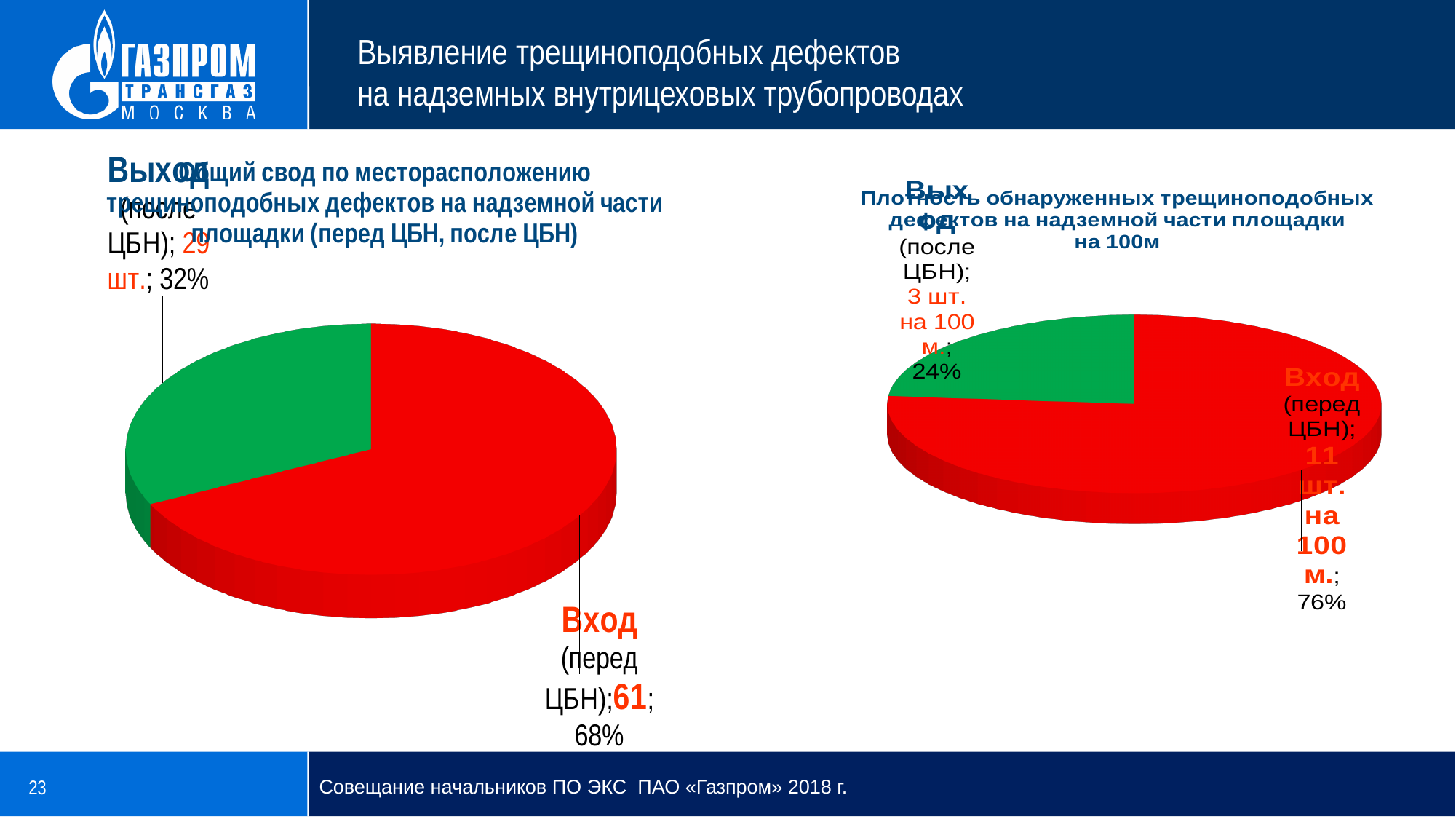
In the left pie chart, how many defects are shown for Выход (после ЦБН)? 29 шт. In the left pie chart, what share of the pie does Выход (после ЦБН) take? 32% In the right pie chart, which category has the smallest slice? Выход (после ЦБН) In the right pie chart, what is the defect density for Выход (после ЦБН)? 3 шт. на 100 м. How many slices does the left pie chart have? 2 What type of chart is the left chart on the slide? Pie chart In the left pie chart, what share of the pie does Вход (перед ЦБН) take? 68% In the right pie chart, what share of the pie does Вход (перед ЦБН) take? 76% In the right pie chart, what is the defect density for Вход (перед ЦБН)? 11 шт. на 100 м. In the left pie chart, which category has the largest slice? Вход (перед ЦБН) In the left pie chart, how many defects are shown for Вход (перед ЦБН)? 61 In the left pie chart, what is the difference between the number of defects for Вход (перед ЦБН) and Выход (после ЦБН)? 32